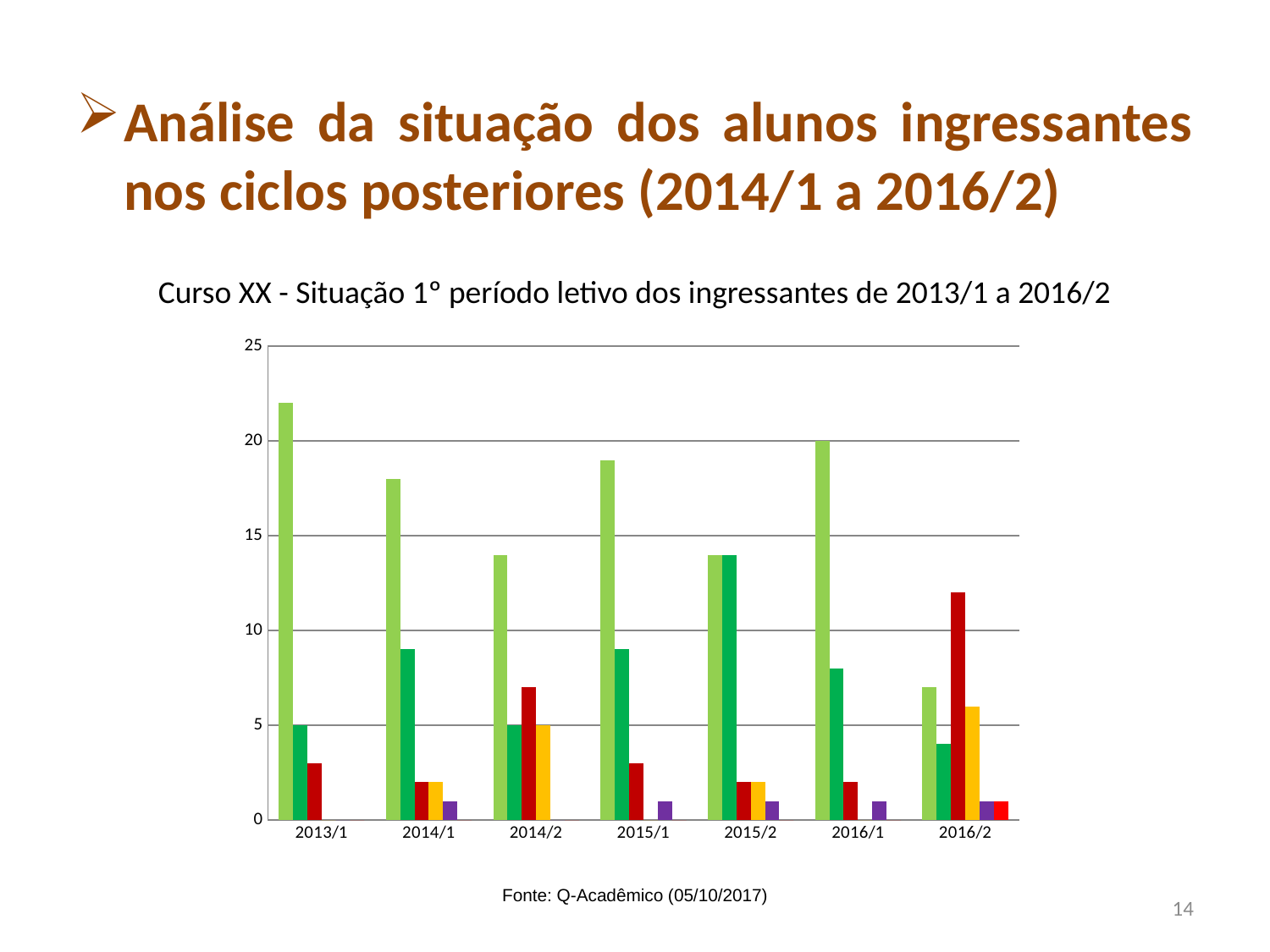
Which is larger, the light green bar for 2015/1 or the light green bar for 2014/2? 2015/1 Which period has the tallest light green bar? 2013/1 Which is larger, the dark green bar for 2015/2 or the dark green bar for 2016/1? 2015/2 How many periods are shown on the x axis of the chart? 7 What kind of chart is shown on the slide? bar chart What is the title of the chart? Curso XX - Situação 1º período letivo dos ingressantes de 2013/1 a 2016/2 Is the dark red bar for 2016/2 greater or less than 10? greater Is the dark green bar for 2015/2 greater or less than 10? greater Which period has the shortest light green bar? 2016/2 Is the light green bar for 2014/2 greater or less than 15? less What source is cited below the chart? Fonte: Q-Acadêmico (05/10/2017)